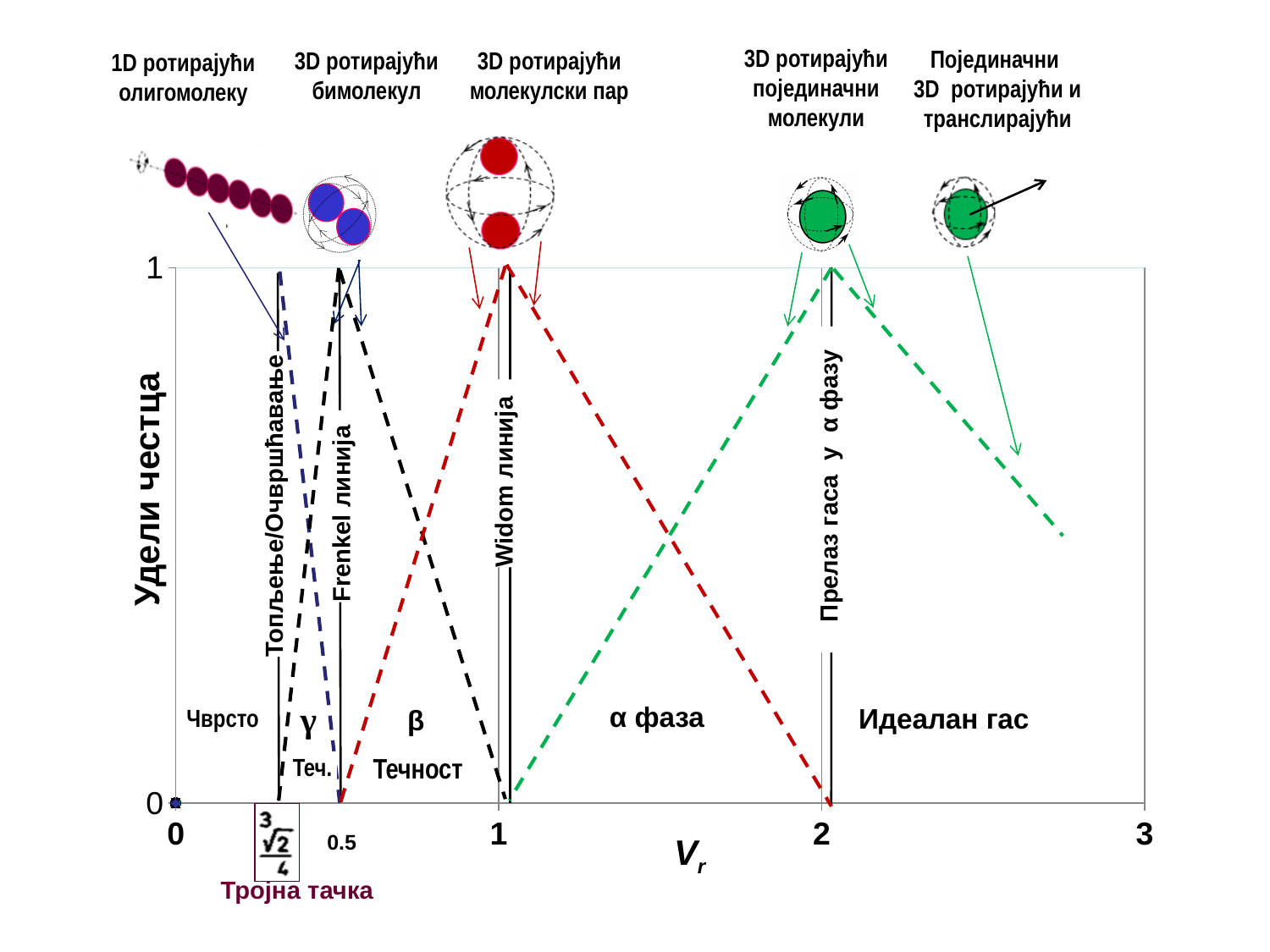
What kind of chart is shown on the slide? line chart At what value of Vr does the black dashed line reach its peak value of 1? 0.5 At what value of Vr does the red dashed line reach its peak value of 1? 1 What is the label of the y axis? Удели честца Does the green dashed line rise or fall as Vr increases from 1 to 2? rise Does the red dashed line rise or fall as Vr increases from 1 to 2? fall What is the value of the red dashed line at Vr = 2? 0 What is the label of the x axis? Vr What is the value of the green dashed line at Vr = 1? 0 What is the maximum value shown on the x axis? 3 At Vr = 1, which line has the larger value, the red dashed line or the black dashed line? red dashed line At what value of Vr does the green dashed line reach its peak value of 1? 2